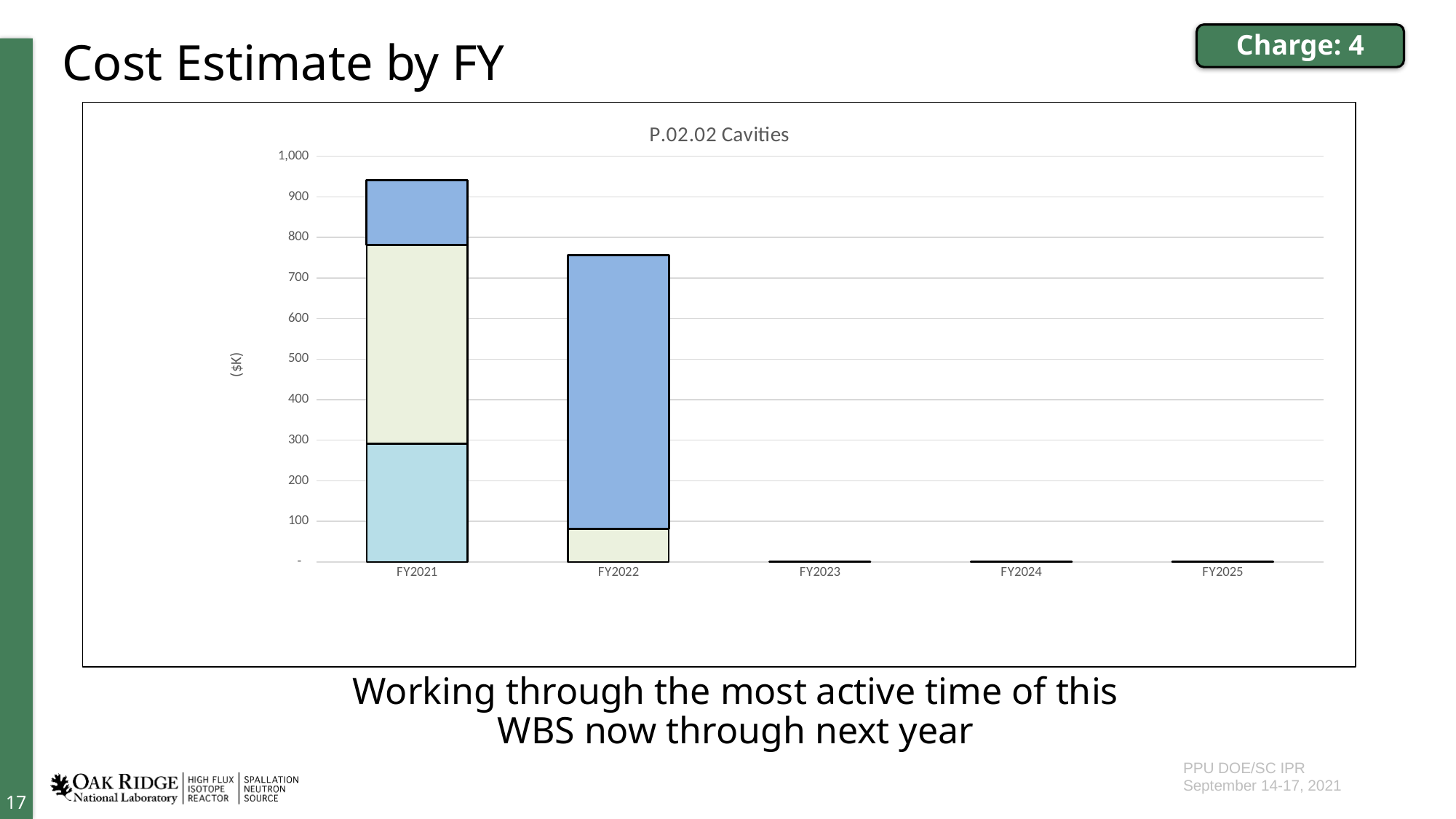
Is the total bar for FY2021 greater or less than 1,000? less Is the total bar for FY2022 greater or less than 800? less How many fiscal year categories are shown on the x axis? 5 Which is larger, the total bar for FY2021 or for FY2022? FY2021 Do the total bar values rise or fall from FY2021 to FY2023? fall Which fiscal year has the highest total bar? FY2021 What type of chart is shown on the slide? Stacked bar chart Is the total bar for FY2022 greater or less than 700? greater What is the title of the chart? P.02.02 Cavities What unit is shown on the vertical axis label of the chart? ($K)